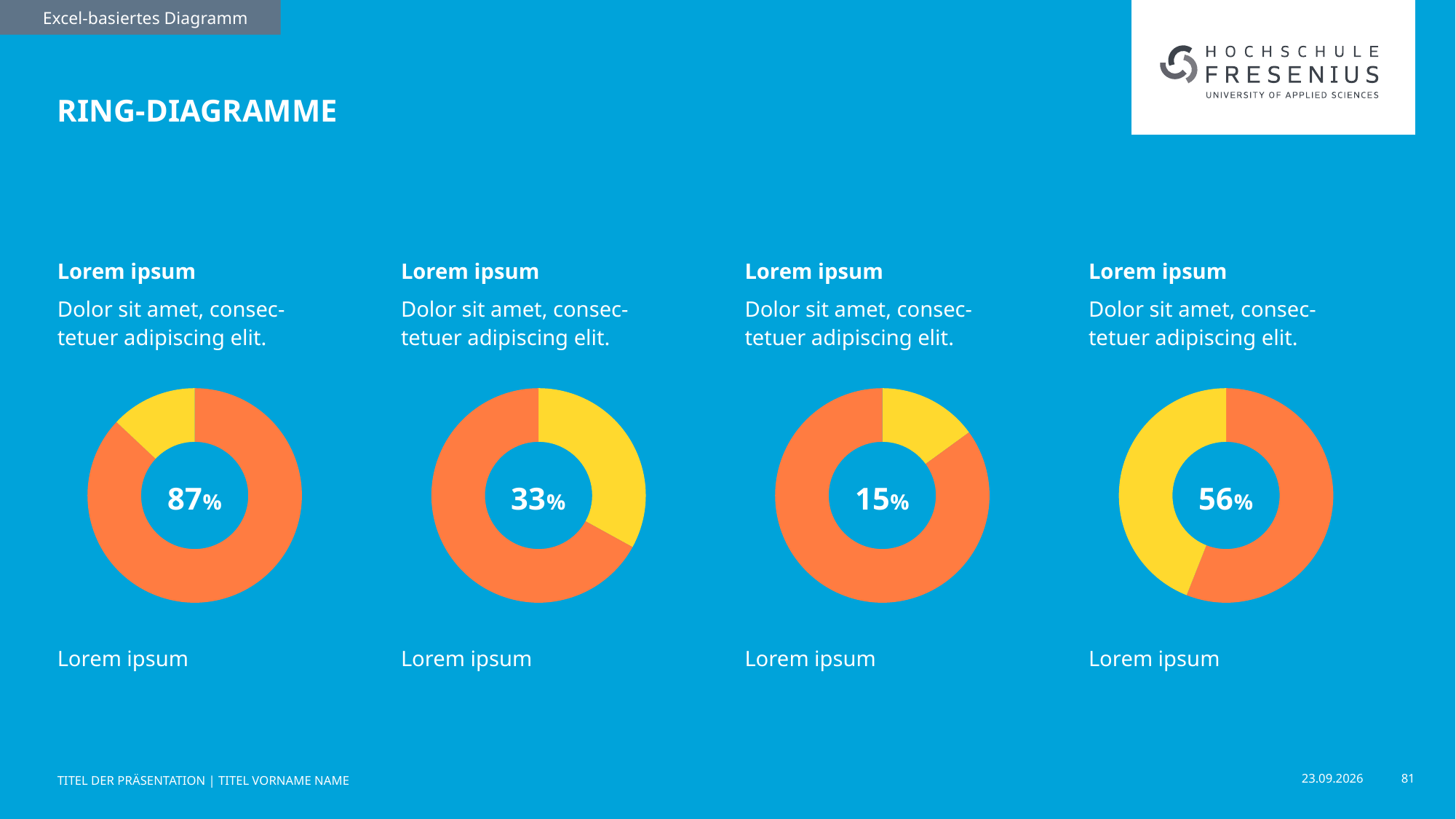
What percentage is shown in the centre of the second ring chart from the left? 33% What percentage is shown in the centre of the rightmost ring chart? 56% What is the difference between the percentage in the leftmost ring chart and the percentage in the rightmost ring chart? 31% What percentage is shown in the centre of the third ring chart from the left? 15% What percentage is shown in the centre of the leftmost ring chart? 87% Which is larger: the percentage in the second ring chart from the left or the percentage in the rightmost ring chart? The rightmost chart (56%) Is the percentage shown in the second ring chart from the left greater or less than 50%? less What type of chart is used on this slide? Ring (doughnut) chart Which of the four ring charts shows the highest percentage? The leftmost chart (87%) Which two colours are used for the segments of the ring charts? Orange and yellow How many ring charts are shown on the slide? 4 Which of the four ring charts shows the lowest percentage? The third chart from the left (15%)